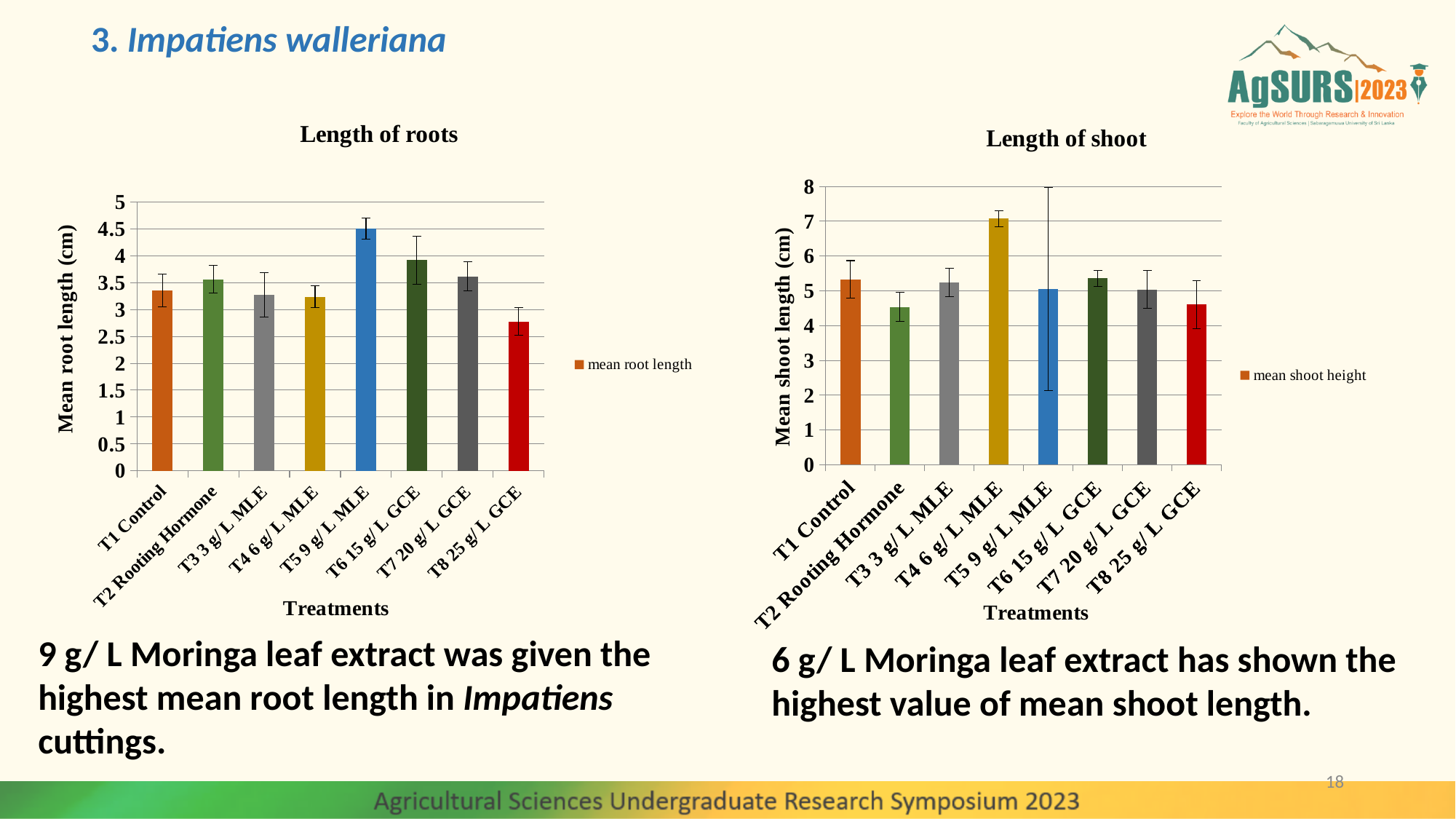
How many treatments are shown in the 'Length of roots' chart? 8 In the 'Length of shoot' chart, which treatment has the highest mean shoot length? T4 6 g/ L MLE In the 'Length of roots' chart, which treatment has the highest mean root length? T5 9 g/ L MLE What kind of chart is the 'Length of shoot' chart? bar chart In the 'Length of shoot' chart, which is larger: the value for T4 6 g/ L MLE or T1 Control? T4 6 g/ L MLE In the 'Length of roots' chart, which treatment has the lowest mean root length? T8 25 g/ L GCE In the 'Length of shoot' chart, is the value for T4 6 g/ L MLE greater or less than 6? greater In the 'Length of roots' chart, is the value for T8 25 g/ L GCE greater or less than 3? less How many series does the legend of the 'Length of shoot' chart list? 1 In the 'Length of shoot' chart, is the value for T2 Rooting Hormone greater or less than 5? less In the 'Length of roots' chart, which is larger: the value for T6 15 g/ L GCE or T7 20 g/ L GCE? T6 15 g/ L GCE